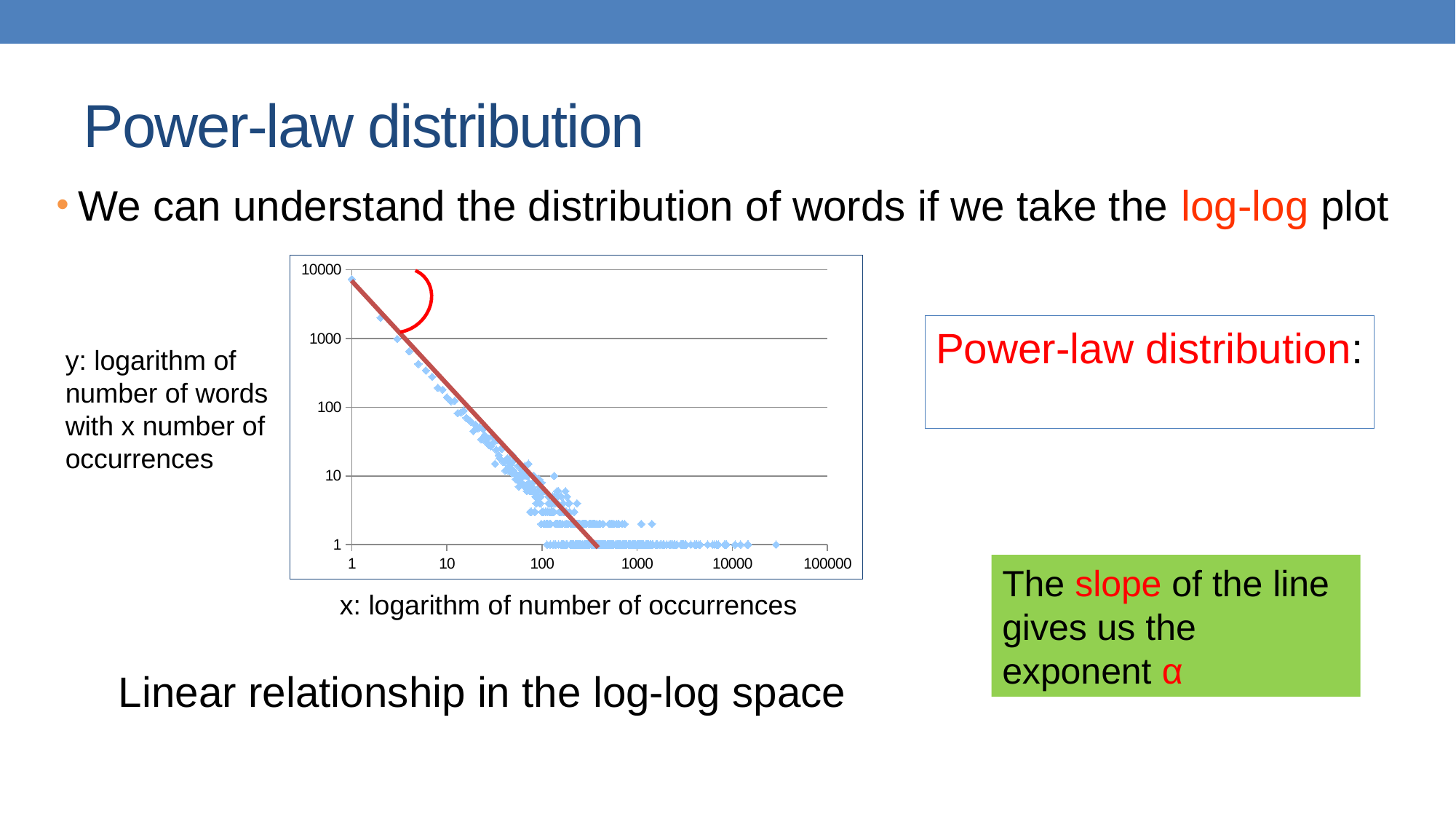
Are the y values of the points around x = 100 greater or less than 100? less At which x-axis value does the scatter reach its highest y value? 1 What kind of chart is shown on the slide? scatter chart What is the label of the x axis of the chart? x: logarithm of number of occurrences What is the lowest y value that the plotted points reach? 1 Are the y values of the points at x = 10000 greater or less than 10? less What is the label of the y axis of the chart? y: logarithm of number of words with x number of occurrences Do the plotted y values rise or fall as the number of occurrences on the x axis increases? fall Is the y value of the point at x = 1 greater or less than 1000? greater